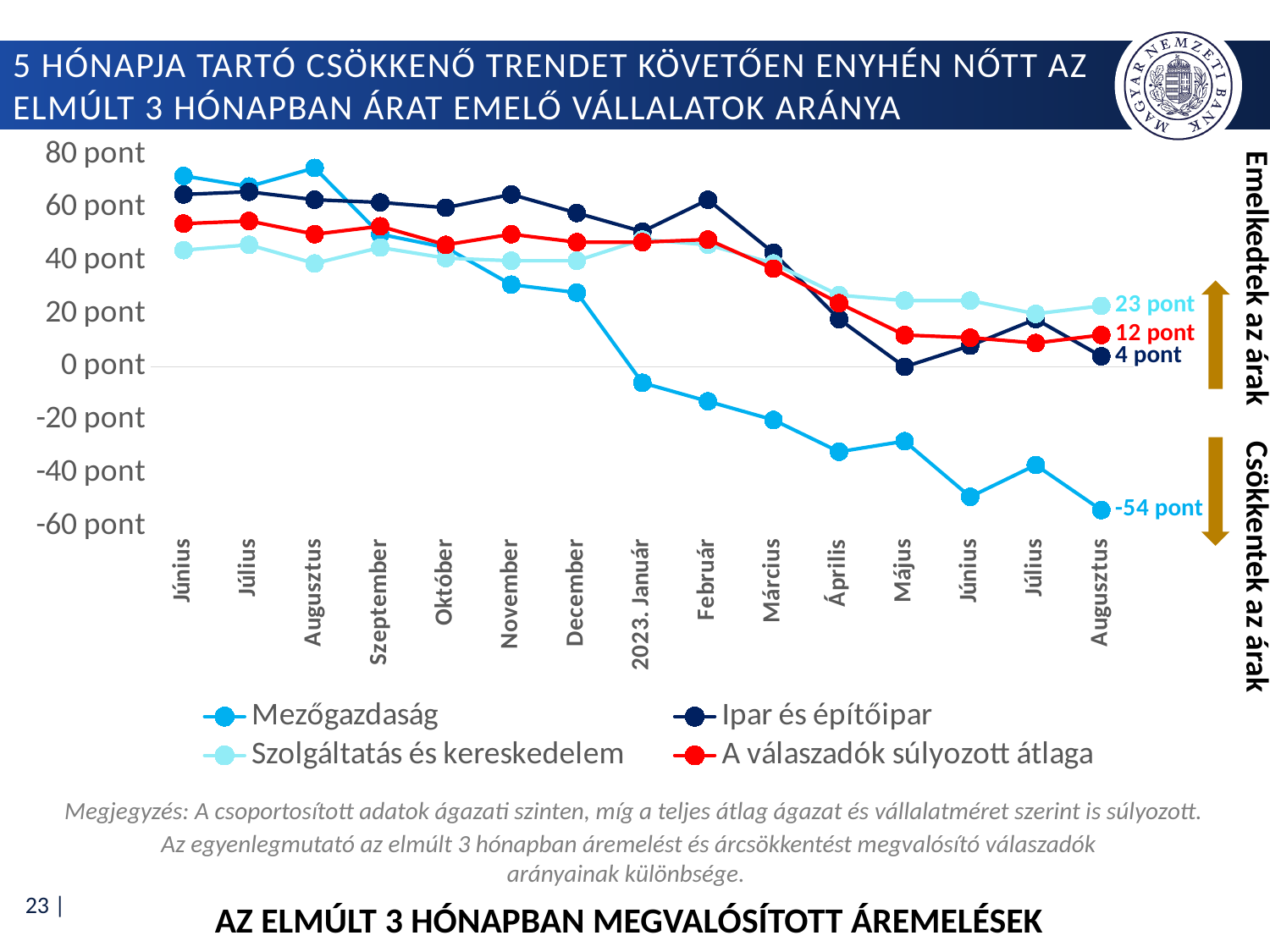
What is the difference between the Szolgáltatás és kereskedelem value and the Ipar és építőipar value at the last point (Augusztus)? 19 pont Is the value for Mezőgazdaság in the first Június greater or less than 60 pont? greater How many points are on the x axis of the chart? 15 Does the Mezőgazdaság series generally rise or fall along the x axis? fall Which series has the lowest value at the last point (Augusztus)? Mezőgazdaság What is the value for Szolgáltatás és kereskedelem in Augusztus (the last point)? 23 pont What is the value for Mezőgazdaság in Augusztus (the last point)? -54 pont What is the value for Ipar és építőipar in Augusztus (the last point)? 4 pont What type of chart is shown on the slide? line chart What is the value for A válaszadók súlyozott átlaga in Augusztus (the last point)? 12 pont Which series has the highest value at the last point (Augusztus)? Szolgáltatás és kereskedelem How many series does the legend list? 4